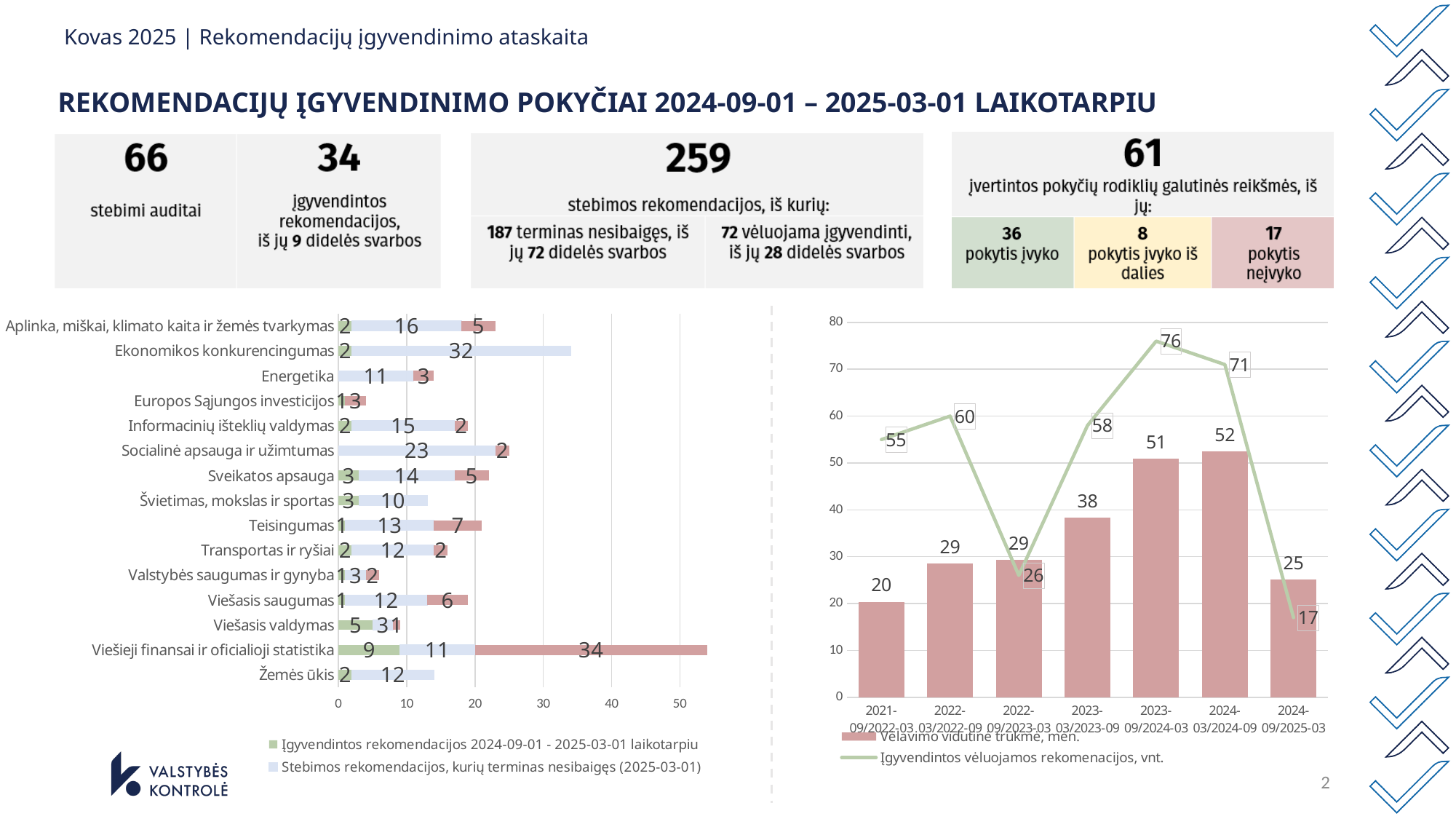
In the right chart, what is the difference between the highest line value (76) and the lowest line value (17)? 59 In the left bar chart, what is the value of the red segment for Viešieji finansai ir oficialioji statistika? 34 In the left bar chart, what is the value of the green 'Įgyvendintos rekomendacijos' segment for Viešieji finansai ir oficialioji statistika? 9 How many series does the legend of the left bar chart list? 2 In the left bar chart, what is the value of the blue 'Stebimos rekomendacijos' segment for Ekonomikos konkurencingumas? 32 What kind of chart is shown on the right side of the slide? Combination bar and line chart How many categories are listed on the vertical axis of the left bar chart? 15 In the right chart, what is the value of the bar for 2023-09/2024-03? 51 In the right chart, what is the value of the line 'Įgyvendintos vėluojamos rekomenacijos, vnt.' for 2022-03/2022-09? 60 In the right chart, which bar is larger: 2023-03/2023-09 or 2022-09/2023-03? 2023-03/2023-09 In the right chart, which period has the lowest bar value? 2021-09/2022-03 In the right chart, which period has the highest value on the line series? 2023-09/2024-03